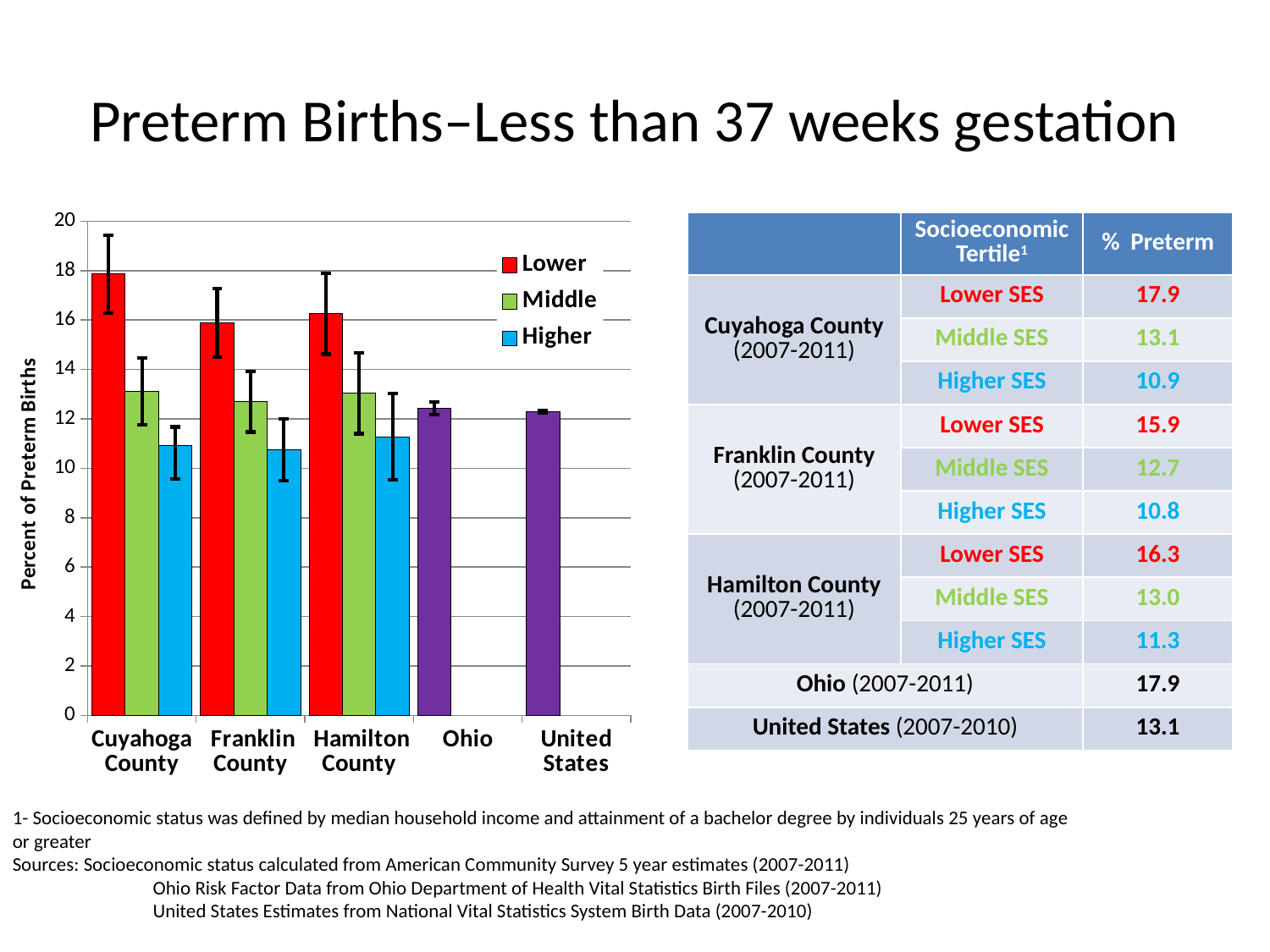
Which is larger, the Middle SES value for Franklin County or the Middle SES value for Hamilton County? Hamilton County What is the title of the chart's vertical axis? Percent of Preterm Births Which county has the lowest percent of preterm births for the Higher SES tertile? Franklin County Is the value of the Ohio bar greater or less than 14? less How many categories are shown along the x axis of the chart? 5 What kind of chart is shown on the slide? bar chart Within each county, do the values rise or fall going from the Lower SES bar to the Higher SES bar? fall What is the percent of preterm births for the Higher SES tertile in Hamilton County? 11.3 Which county has the highest percent of preterm births for the Lower SES tertile? Cuyahoga County How many series does the chart legend list? 3 What is the difference between the Lower SES and Higher SES preterm birth percentages in Cuyahoga County? 7.0 What is the percent of preterm births for the Lower SES tertile in Cuyahoga County? 17.9